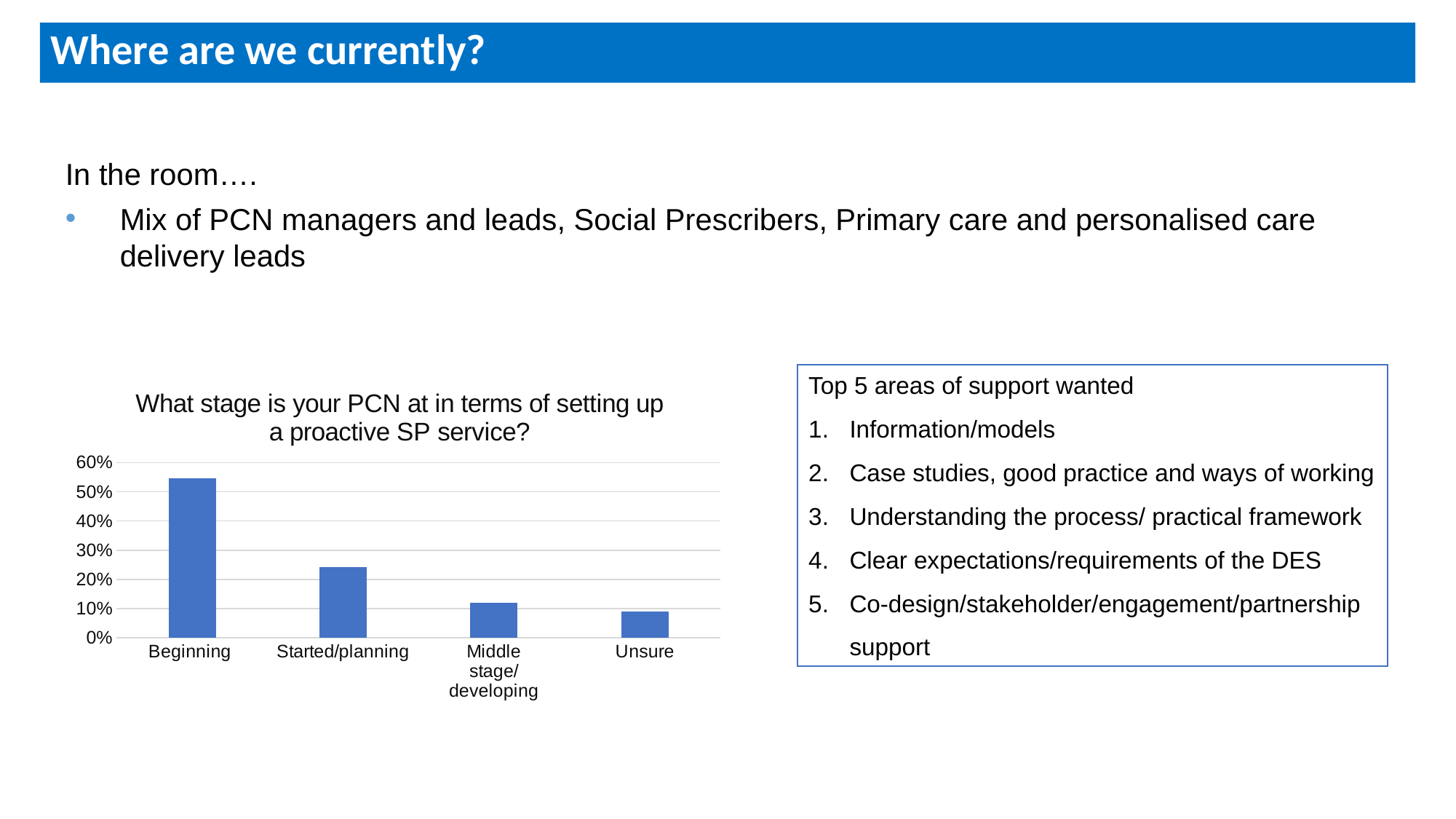
Which category has the lowest value in the chart? Unsure Which category has the highest value in the chart? Beginning What is the highest value shown on the chart's y axis? 60% Do the values rise or fall moving from left to right along the x axis? fall How many categories are shown on the x axis of the chart? 4 Is the value for Middle stage/developing greater or less than 10%? greater Which is larger, the value for Started/planning or the value for Middle stage/developing? Started/planning Is the value for Started/planning greater or less than 30%? less What is the title of the chart? What stage is your PCN at in terms of setting up a proactive SP service? What kind of chart is shown on the slide? bar chart Is the value for Beginning greater or less than 50%? greater